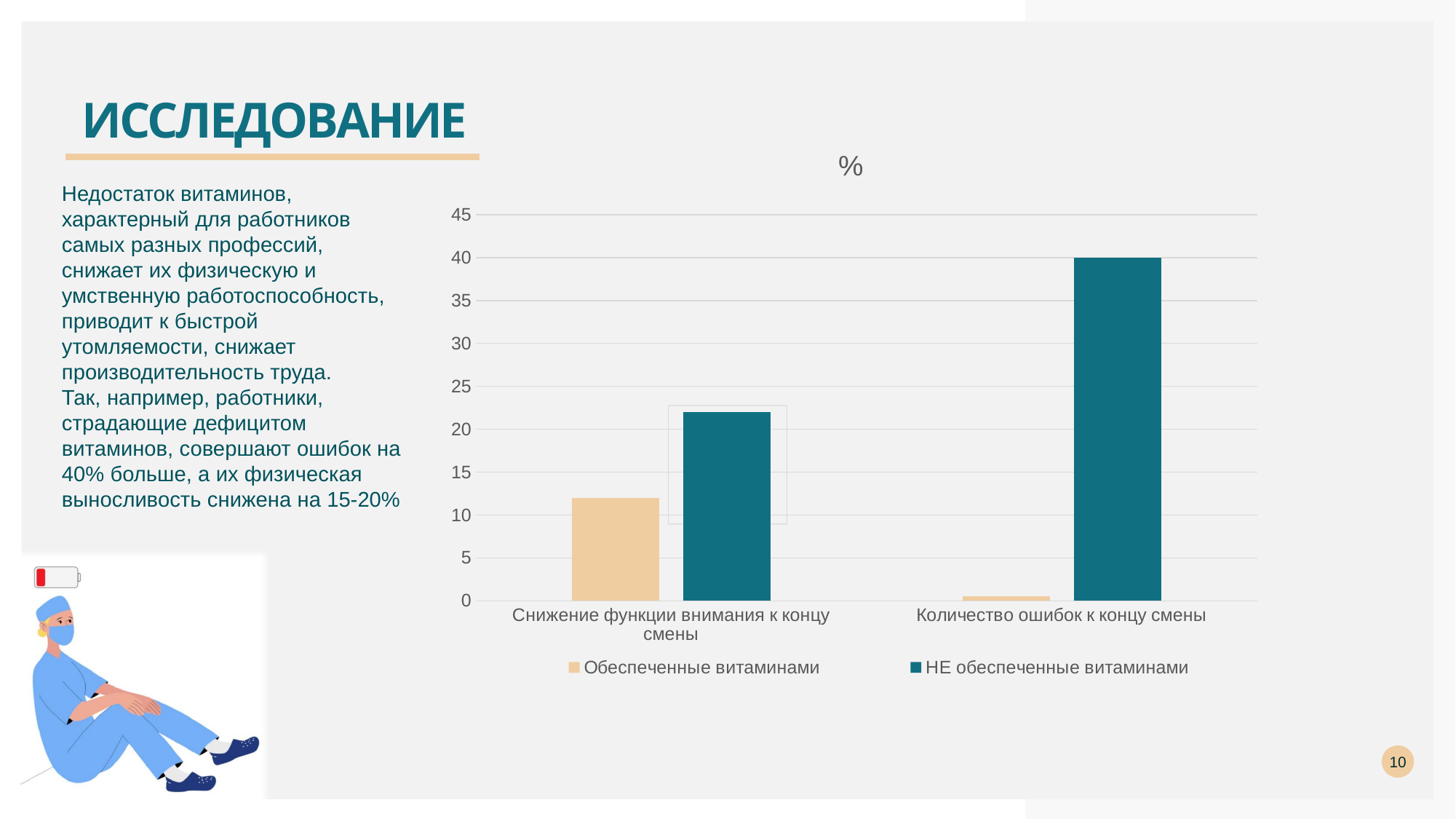
What kind of chart is shown on the slide? bar chart How many series does the chart legend list? 2 Which series has the higher value in the category 'Снижение функции внимания к концу смены'? НЕ обеспеченные витаминами Is the value for 'Обеспеченные витаминами' in 'Снижение функции внимания к концу смены' greater or less than 15? less Is the value for 'НЕ обеспеченные витаминами' in 'Снижение функции внимания к концу смены' greater or less than 20? greater What is the value for 'НЕ обеспеченные витаминами' in the category 'Количество ошибок к концу смены'? 40 Which category has the highest bar in the chart? Количество ошибок к концу смены What is the title of the chart? % Is the value for 'Обеспеченные витаминами' in 'Количество ошибок к концу смены' greater or less than 5? less Which series has the higher value in the category 'Количество ошибок к концу смены'? НЕ обеспеченные витаминами How many categories are shown on the x axis of the chart? 2 Which legend entry is shown in dark teal? НЕ обеспеченные витаминами